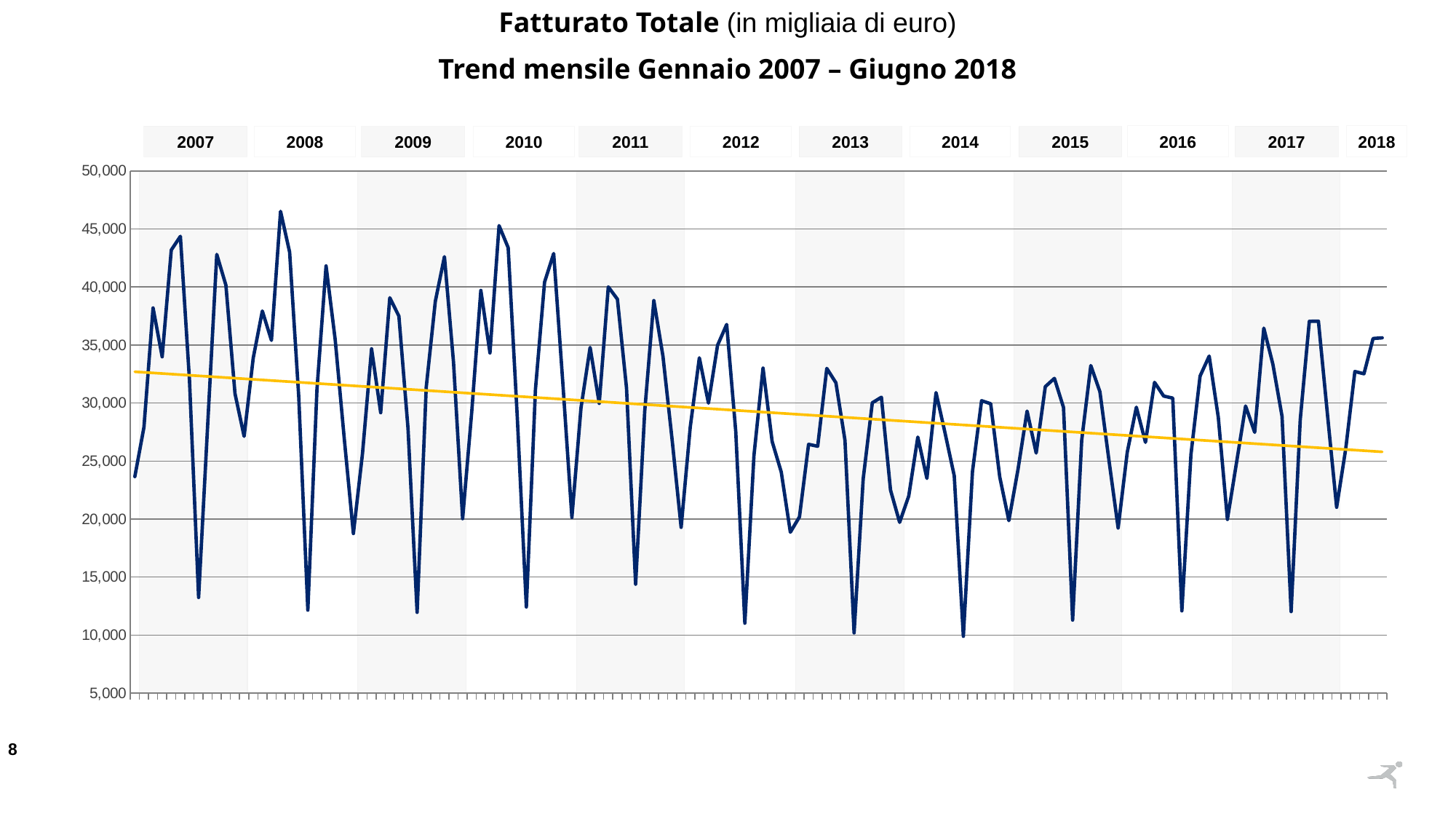
Is the value of the yellow trend line at the start of 2007 greater or less than 30,000? greater Is the lowest point in 2007 greater or less than 15,000? less Does the yellow trend line rise or fall from 2007 to 2018? fall Is the highest peak in 2008 greater or less than 45,000? greater How many years are labelled along the top of the chart? 12 What kind of chart is shown on the slide? line chart Which is larger, the highest peak in 2008 or the highest peak in 2017? 2008 What is the title of the chart? Fatturato Totale (in migliaia di euro) – Trend mensile Gennaio 2007 – Giugno 2018 What is the lowest value shown on the vertical axis? 5,000 In which year does the monthly series reach its highest peak? 2008